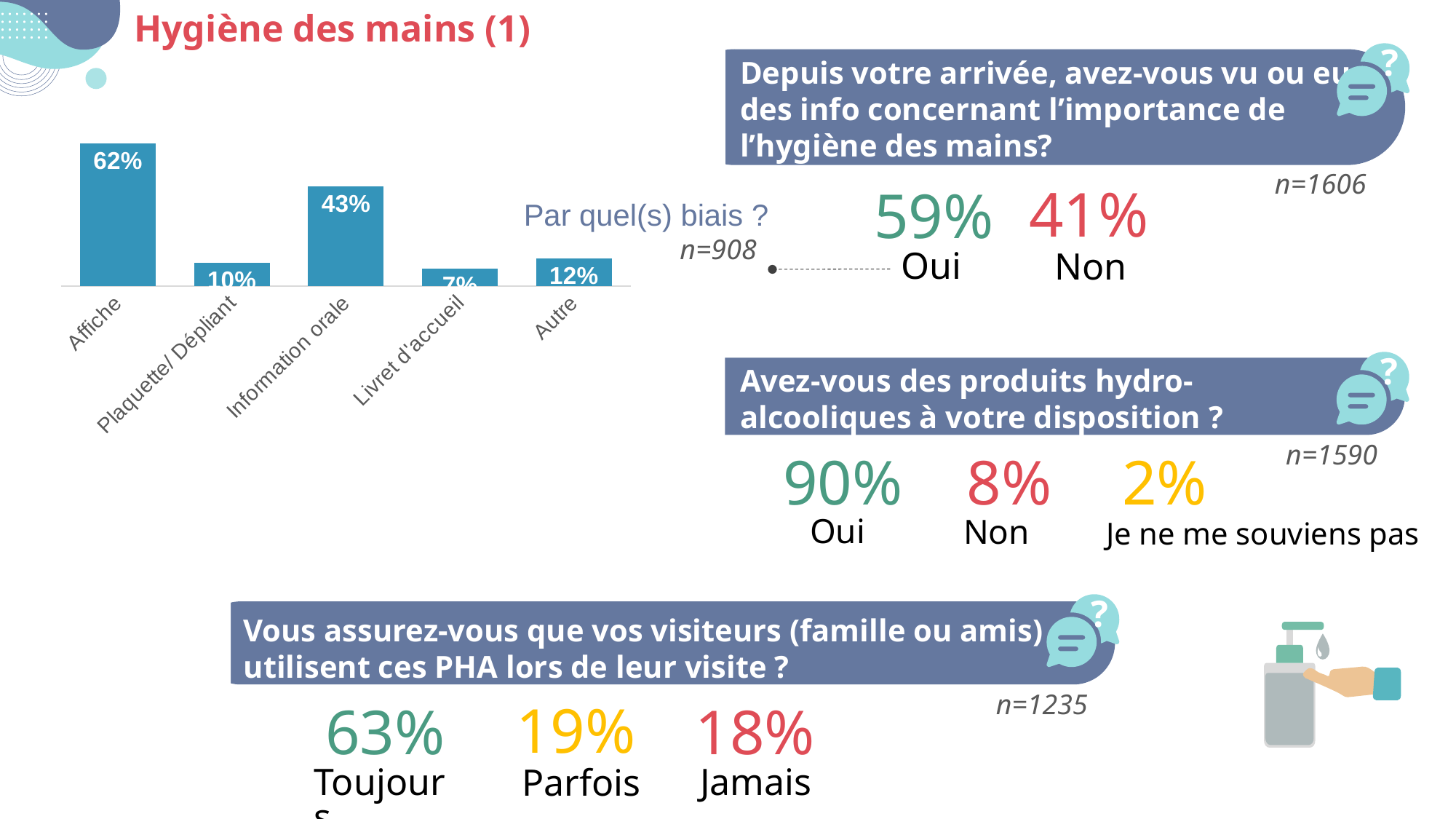
In the bar chart 'Par quel(s) biais ?', which category has the highest value? Affiche In the bar chart 'Par quel(s) biais ?', what is the value for Information orale? 43% In the bar chart 'Par quel(s) biais ?', what is the difference between Affiche and Information orale? 19% How many categories does the bar chart 'Par quel(s) biais ?' show? 5 What sample size (n) is shown next to the bar chart 'Par quel(s) biais ?'? n=908 In the bar chart 'Par quel(s) biais ?', what is the value for Plaquette/ Dépliant? 10% In the bar chart 'Par quel(s) biais ?', what is the value for Livret d'accueil? 7% In the bar chart 'Par quel(s) biais ?', which is larger: Autre or Plaquette/ Dépliant? Autre In the bar chart 'Par quel(s) biais ?', which category has the lowest value? Livret d'accueil What type of chart is 'Par quel(s) biais ?'? Bar chart In the bar chart 'Par quel(s) biais ?', what is the value for Affiche? 62% In the bar chart 'Par quel(s) biais ?', what is the value for Autre? 12%